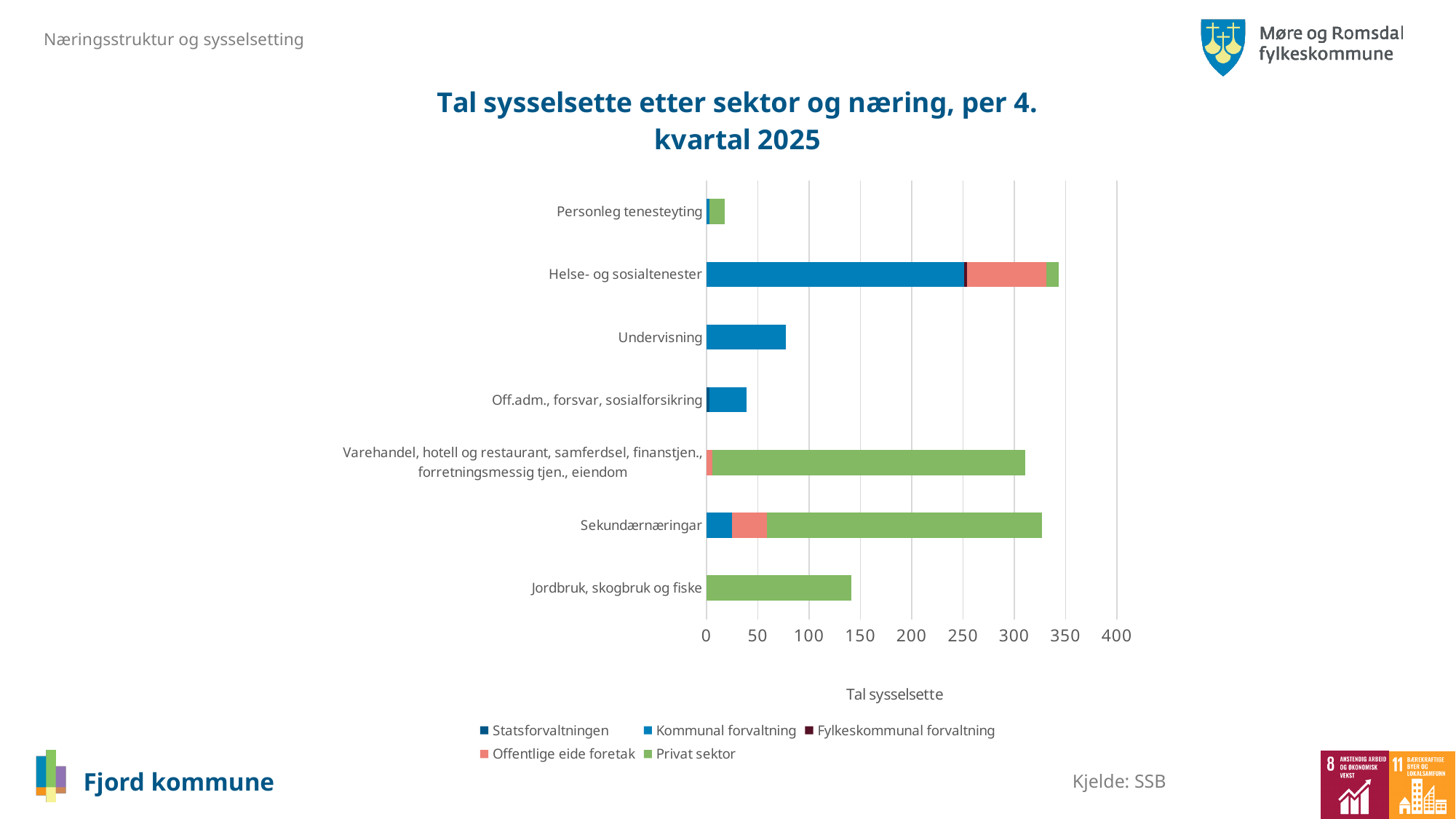
What kind of chart is shown on the slide? Stacked bar chart Is the total value for Undervisning greater or less than 100? less Which has a larger total: Undervisning or Off.adm., forsvar, sosialforsikring? Undervisning How many categories (næringar) are shown on the y axis of the chart? 7 Is the total value for Jordbruk, skogbruk og fiske greater or less than 100? greater Is the total value for Sekundærnæringar greater or less than 300? greater What is the label on the x axis of the chart? Tal sysselsette Which has a larger total: Varehandel, hotell og restaurant, samferdsel, finanstjen., forretningsmessig tjen., eiendom or Jordbruk, skogbruk og fiske? Varehandel, hotell og restaurant, samferdsel, finanstjen., forretningsmessig tjen., eiendom Which category has the lowest total number of employed (tal sysselsette)? Personleg tenesteyting How many series does the legend list? 5